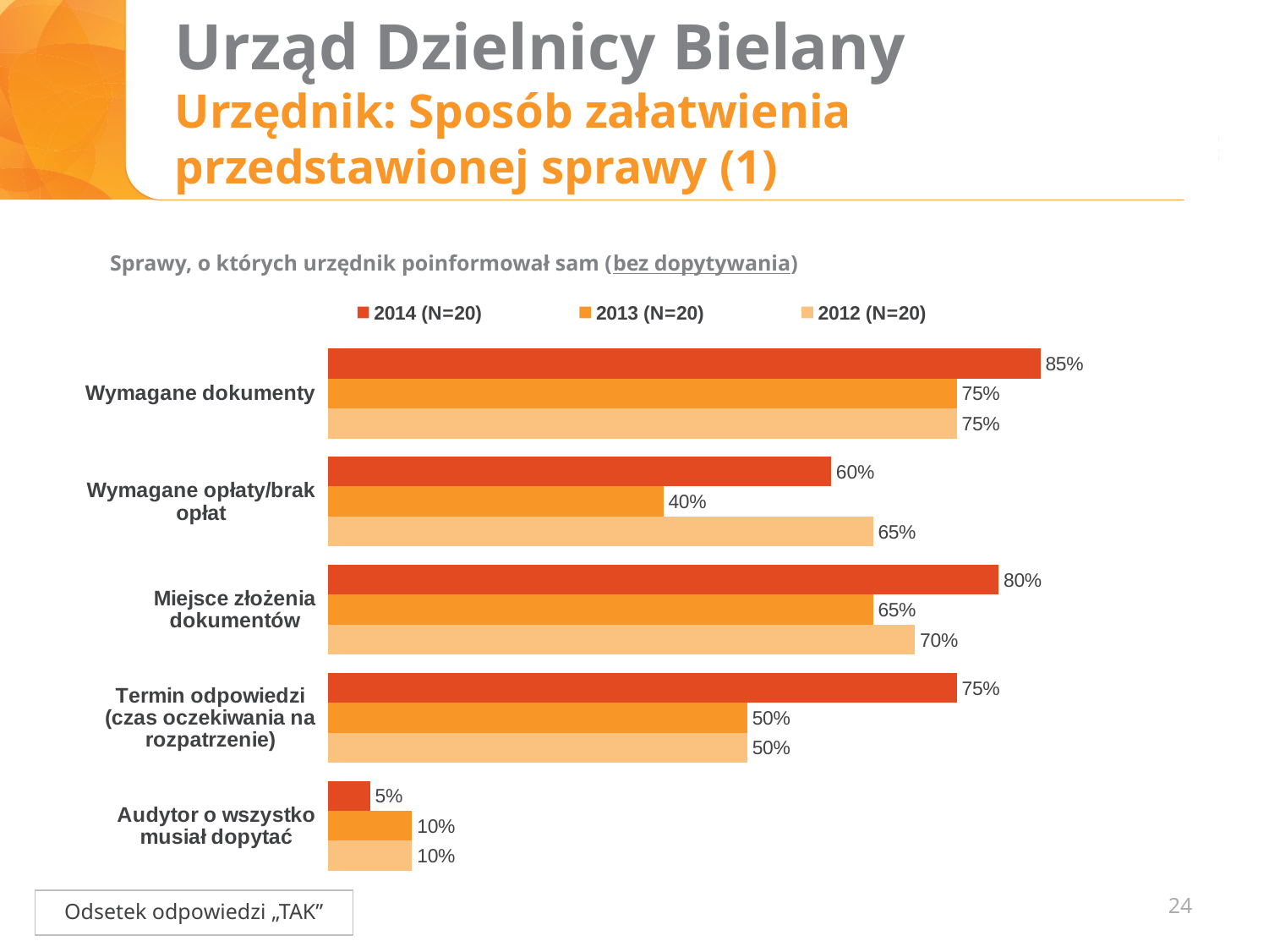
What kind of chart is shown on the slide? Bar chart What is the difference between the 2014 (N=20) and 2013 (N=20) values for Termin odpowiedzi (czas oczekiwania na rozpatrzenie)? 25% What is the value for Audytor o wszystko musiał dopytać in the 2014 (N=20) series? 5% What is the value for Wymagane opłaty/brak opłat in the 2013 (N=20) series? 40% What is the value for Miejsce złożenia dokumentów in the 2012 (N=20) series? 70% What is the value for Wymagane dokumenty in the 2014 (N=20) series? 85% For Wymagane opłaty/brak opłat, which is larger: the 2014 (N=20) value or the 2012 (N=20) value? 2012 (N=20) Which category has the lowest value in the 2012 (N=20) series? Audytor o wszystko musiał dopytać Which series is shown in the darkest red-orange colour? 2014 (N=20) How many categories are shown on the chart? 5 How many series does the legend list? 3 Which category has the highest value in the 2014 (N=20) series? Wymagane dokumenty